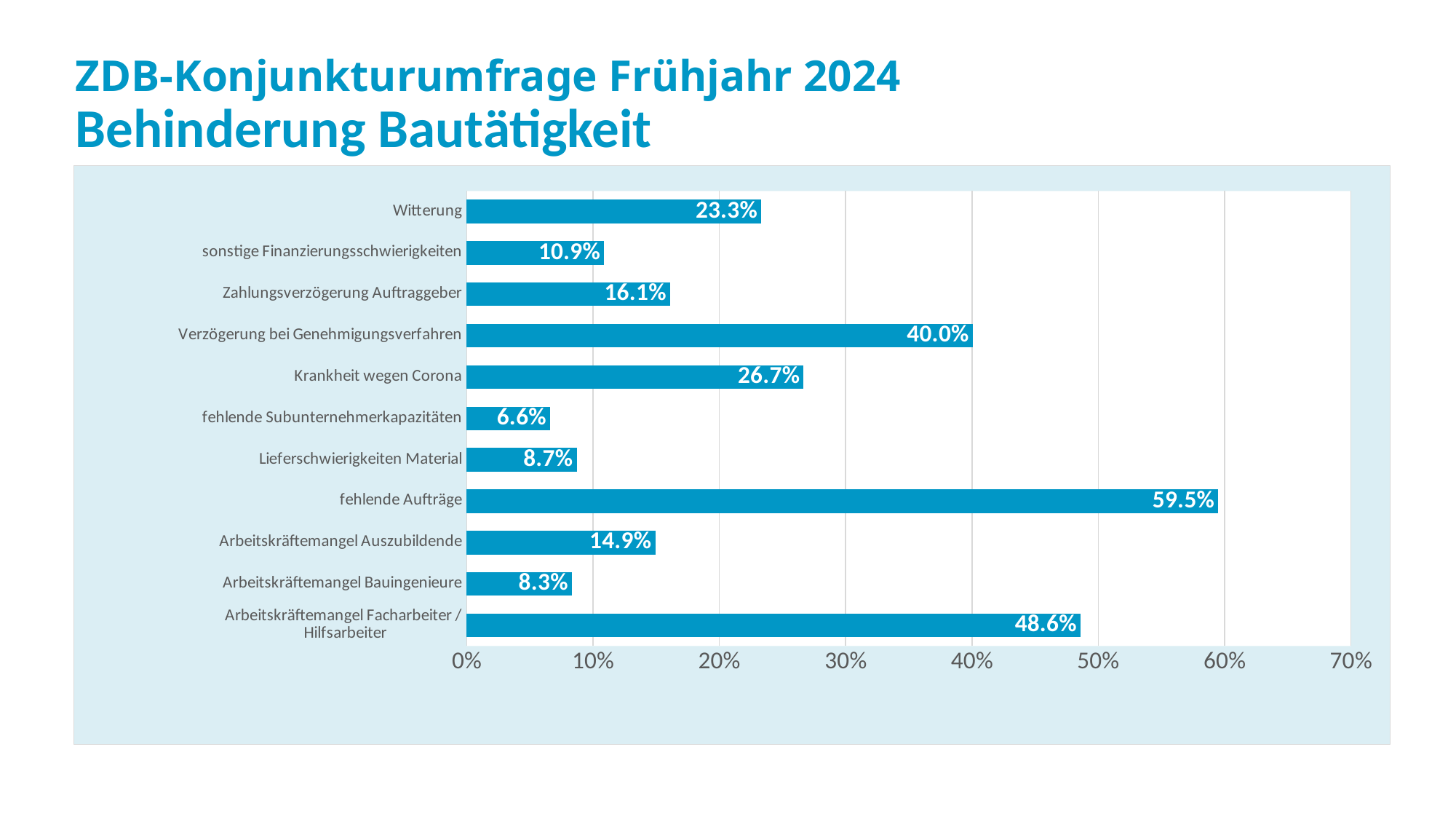
How many categories are shown in the chart? 11 What kind of chart is shown on the slide? bar chart Which category has the highest value? fehlende Aufträge What is the difference between fehlende Aufträge and Arbeitskräftemangel Facharbeiter / Hilfsarbeiter? 10.9% What is the value for Arbeitskräftemangel Facharbeiter / Hilfsarbeiter? 48.6% Which is larger, Krankheit wegen Corona or Witterung? Krankheit wegen Corona Is the value for Zahlungsverzögerung Auftraggeber greater or less than 20%? less What is the value for Verzögerung bei Genehmigungsverfahren? 40.0% Which category has the lowest value? fehlende Subunternehmerkapazitäten What is the value for Witterung? 23.3% What is the title of the slide? ZDB-Konjunkturumfrage Frühjahr 2024 Behinderung Bautätigkeit What is the difference between Lieferschwierigkeiten Material and Arbeitskräftemangel Bauingenieure? 0.4%